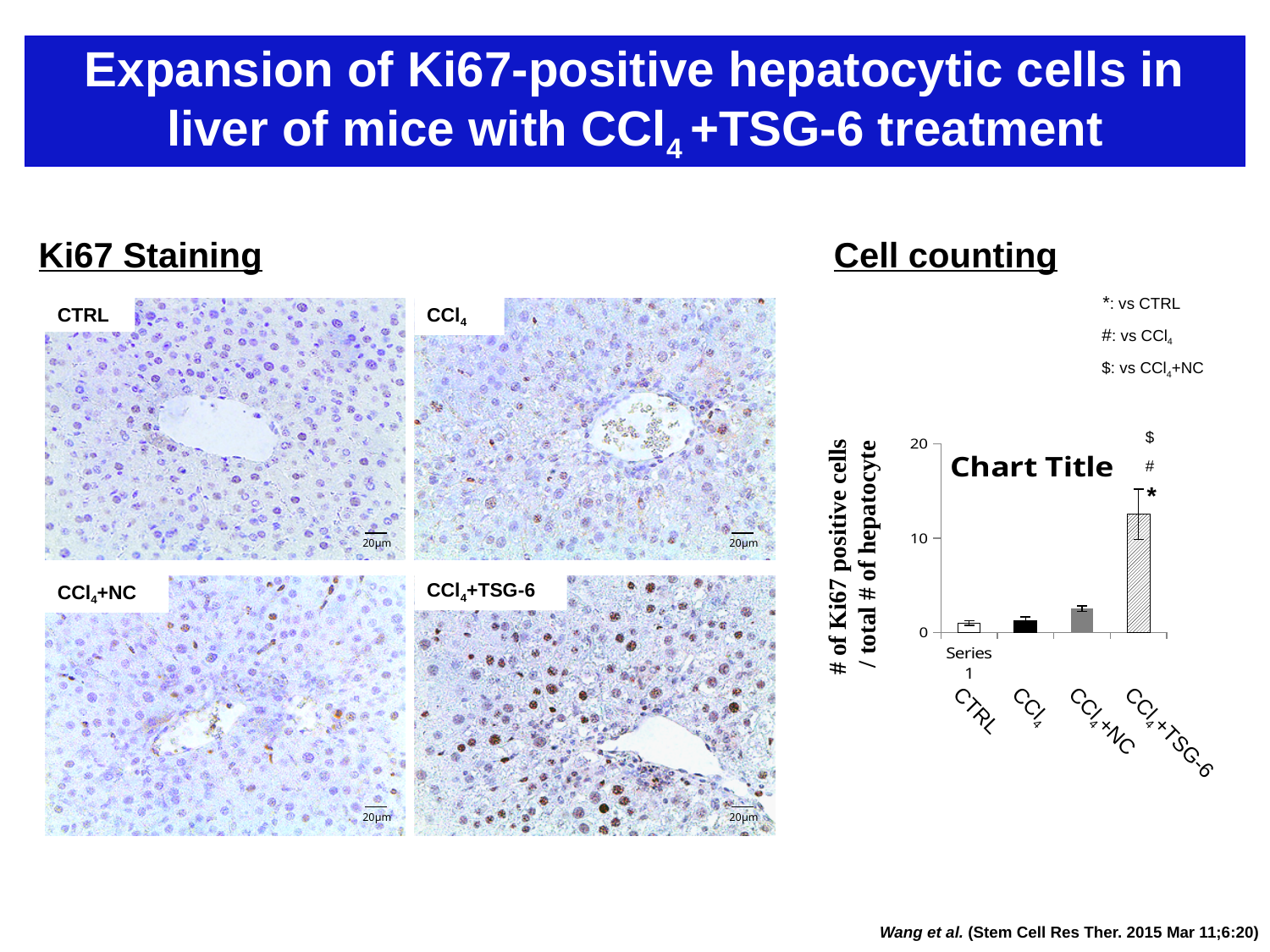
Which is larger, the value for CCl4+TSG-6 or the value for CCl4+NC? CCl4+TSG-6 Is the value for CTRL greater or less than 10? less What kind of chart is shown under "Cell counting"? bar chart Is the value for CCl4 greater or less than 10? less What is the label of the y axis of the bar chart? # of Ki67 positive cells / total # of hepatocyte Is the value for CCl4+TSG-6 greater or less than 10? greater Do the bar values rise or fall from CTRL to CCl4+TSG-6 along the x axis? rise Which is larger, the value for CCl4+NC or the value for CTRL? CCl4+NC Which category has the highest bar in the chart? CCl4+TSG-6 How many categories are plotted on the x axis of the bar chart? 4 What is the title printed on the bar chart? Chart Title